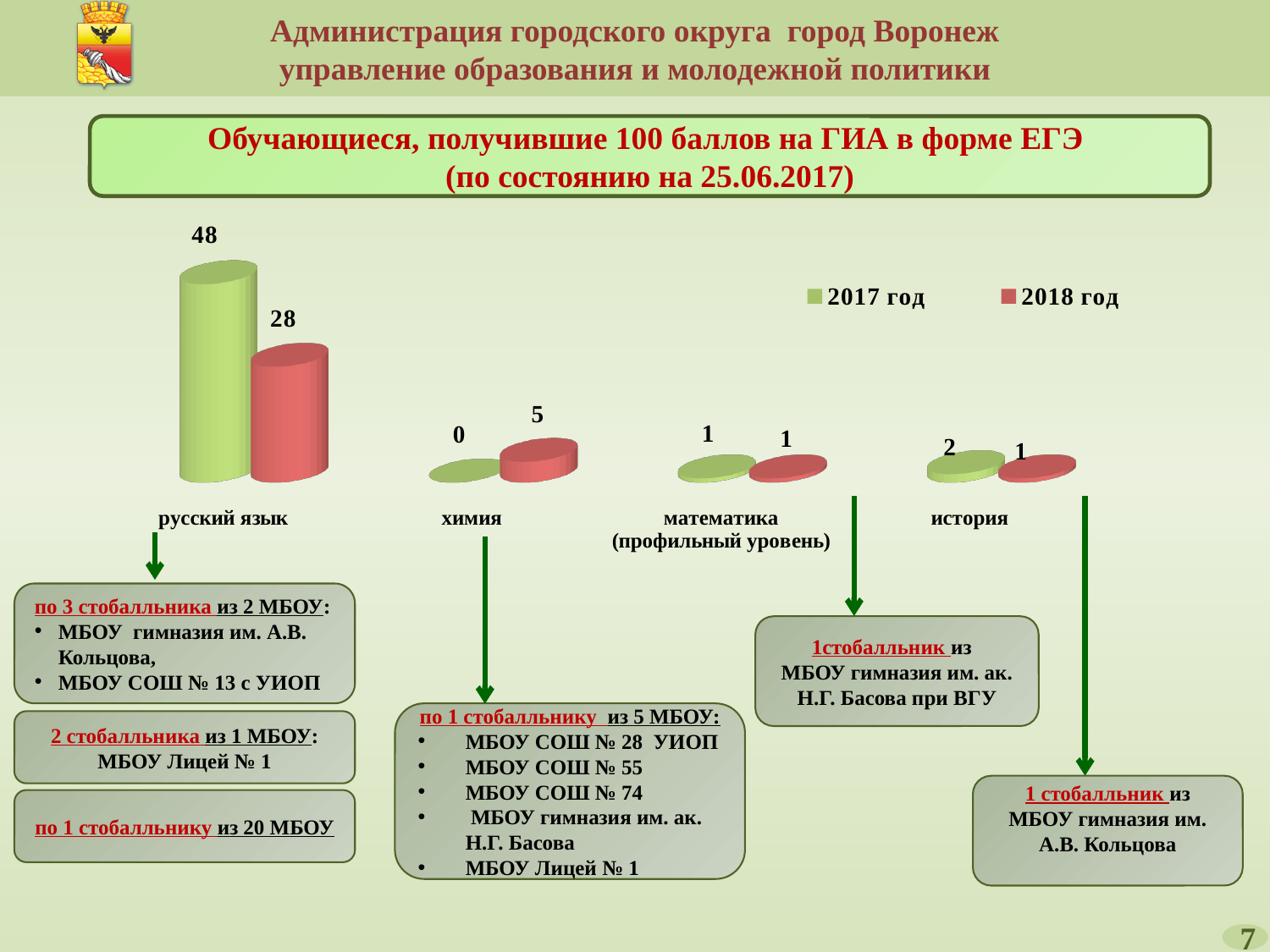
What kind of chart is shown on the slide? bar chart What is the value for химия in the 2018 год series? 5 Which category has the lowest value in the 2017 год series? химия What is the value for история in the 2017 год series? 2 Which is larger for химия: the 2017 год value or the 2018 год value? 2018 год What is the value for русский язык in the 2018 год series? 28 What is the value for русский язык in the 2017 год series? 48 How many series does the legend list? 2 What is the difference between the 2017 год and 2018 год values for русский язык? 20 How many categories are shown on the x axis of the chart? 4 Which colour represents the 2018 год series in the chart? red Which category has the highest value in the 2017 год series? русский язык